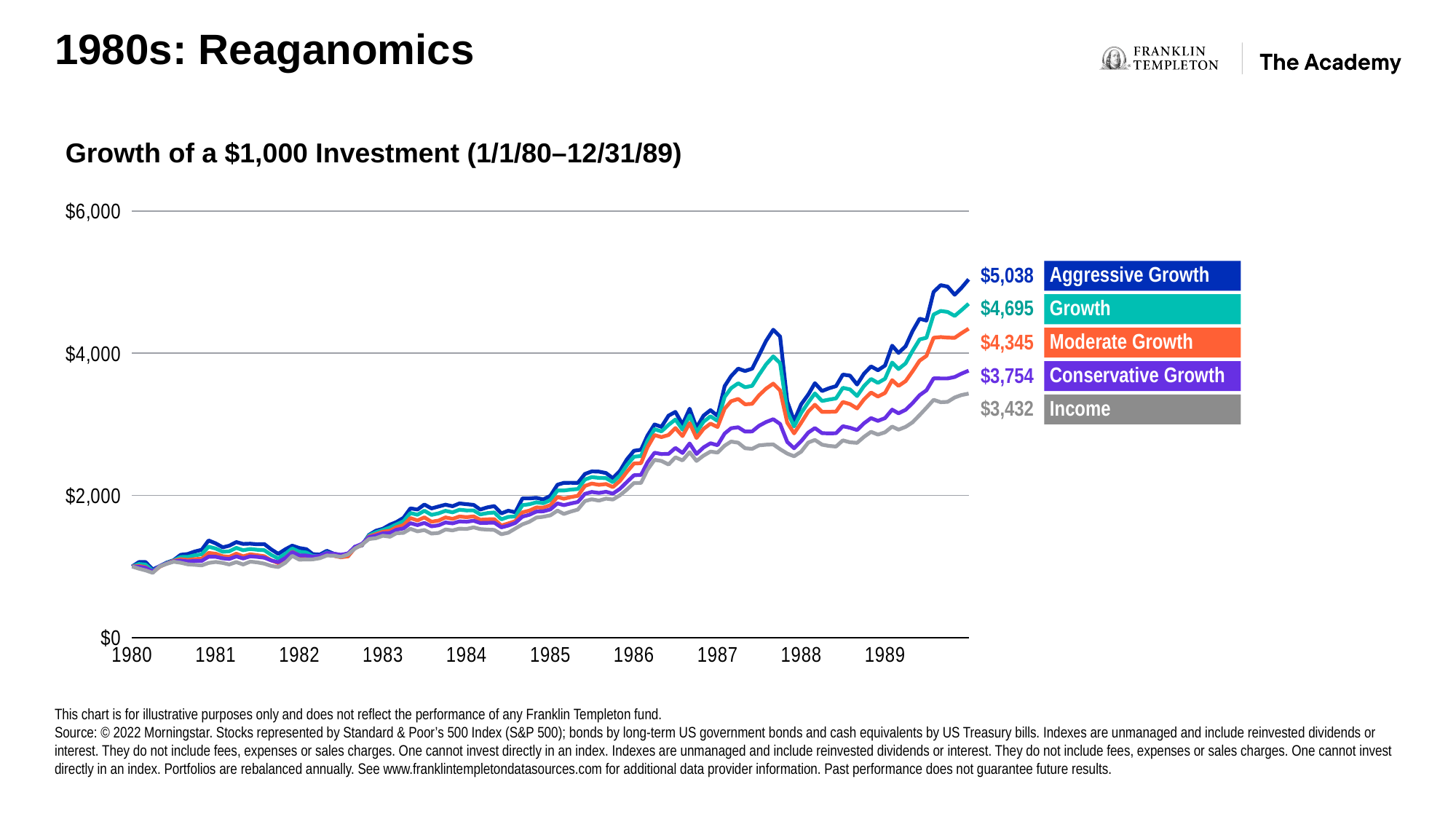
Is the ending value of the Growth portfolio greater or less than $4,000? greater What is the difference between the ending values of Aggressive Growth and Income? $1,606 Do the portfolio values generally rise or fall from 1980 to 1989? Rise What type of chart is shown? Line chart What is the ending value of the Income portfolio? $3,432 What is the ending value of the Aggressive Growth portfolio? $5,038 Which portfolio has the highest ending value? Aggressive Growth Which has a larger ending value, Moderate Growth or Conservative Growth? Moderate Growth How many portfolios are shown in the legend? 5 Which portfolio has the lowest ending value? Income What is the difference between the ending values of Growth and Conservative Growth? $941 What is the ending value of the Moderate Growth portfolio? $4,345